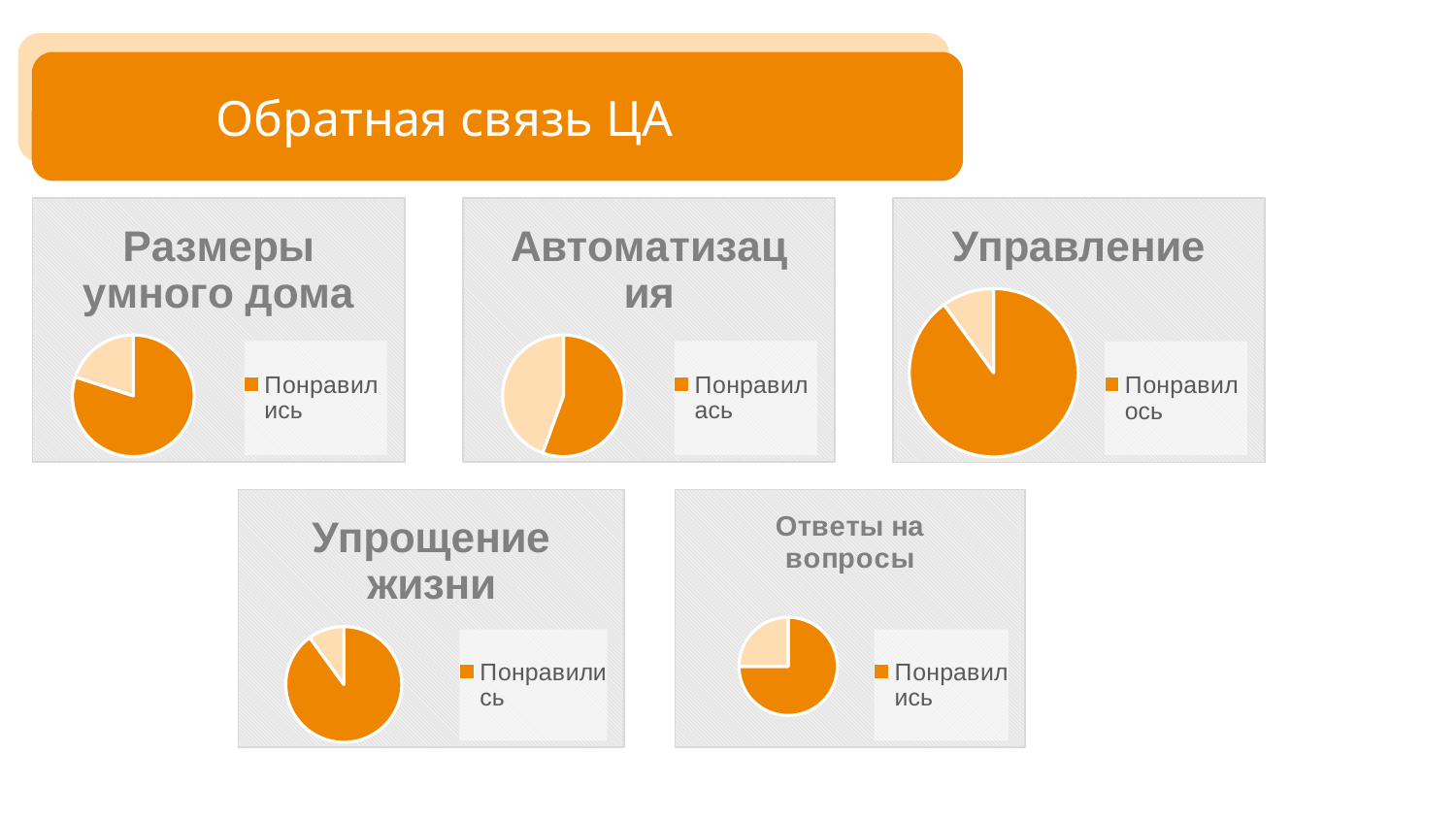
What is the legend entry of the "Управление" chart? Понравилось How many pie charts are shown on the slide? 5 How many slices does the "Ответы на вопросы" pie chart have? 2 Which of the five pie charts has the largest light-coloured slice? Автоматизация What kind of chart is used in the "Управление" panel? pie chart In the "Упрощение жизни" chart, which slice is larger: the dark orange slice or the light slice? the dark orange slice In the "Ответы на вопросы" chart, which slice is smaller: the dark orange slice or the light slice? the light slice What is the legend entry of the "Автоматизация" chart? Понравилась In the "Управление" chart, which slice is larger: the dark orange slice or the light slice? the dark orange slice How many entries does the legend of the "Размеры умного дома" chart list? 1